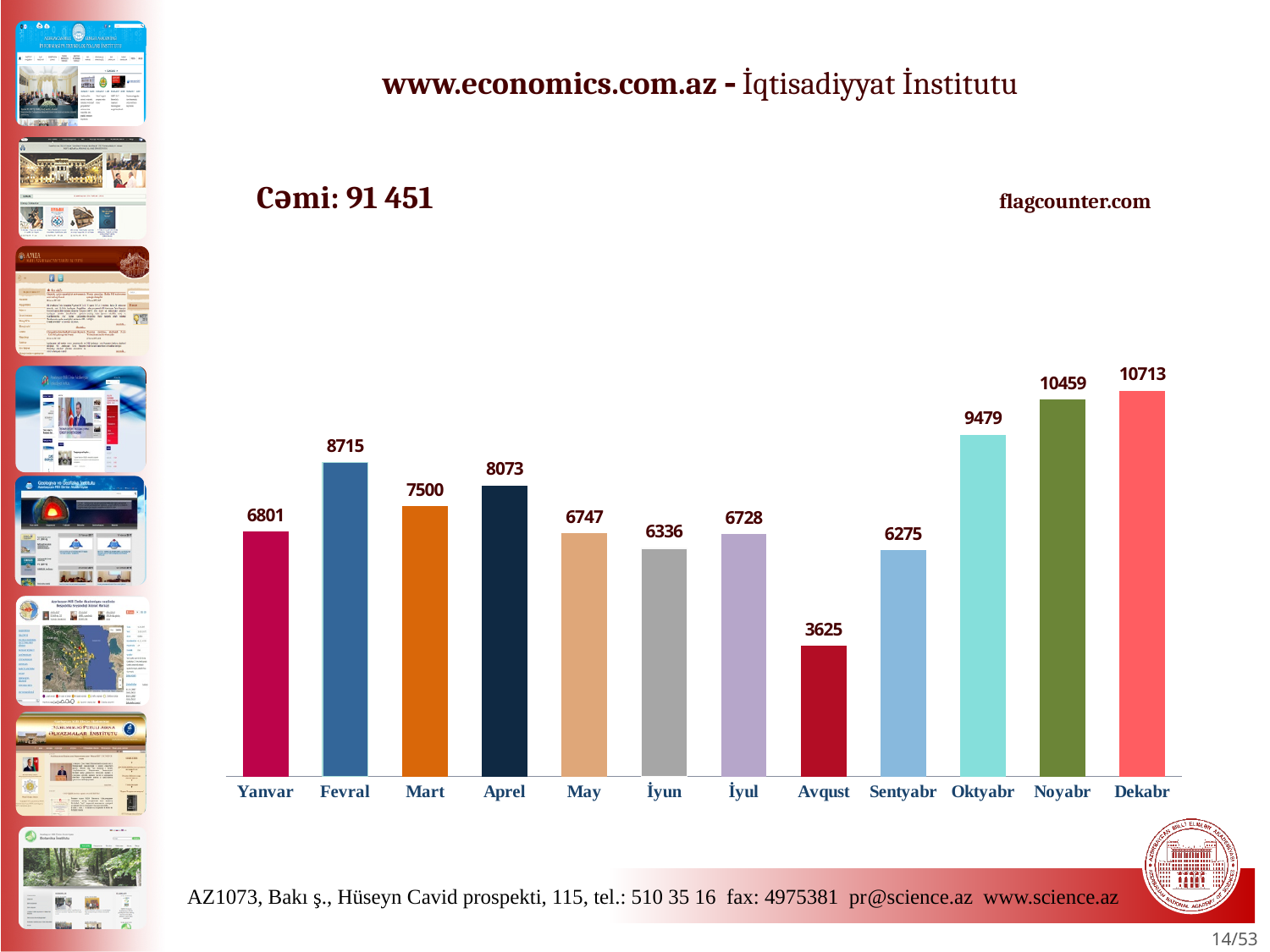
What kind of chart is shown on the slide? Bar chart What is the difference between the values for Dekabr and Noyabr? 254 What is the value for Oktyabr? 9479 Which month has the lowest value? Avqust Which month has the highest value? Dekabr What is the value for Fevral? 8715 Which is larger, the value for Mart or the value for Aprel? Aprel How many months are shown on the chart? 12 Which is larger, the value for May or the value for Sentyabr? May What is the value for Avqust? 3625 What is the difference between the values for Fevral and Yanvar? 1914 What total (Cəmi) is printed above the chart? 91 451